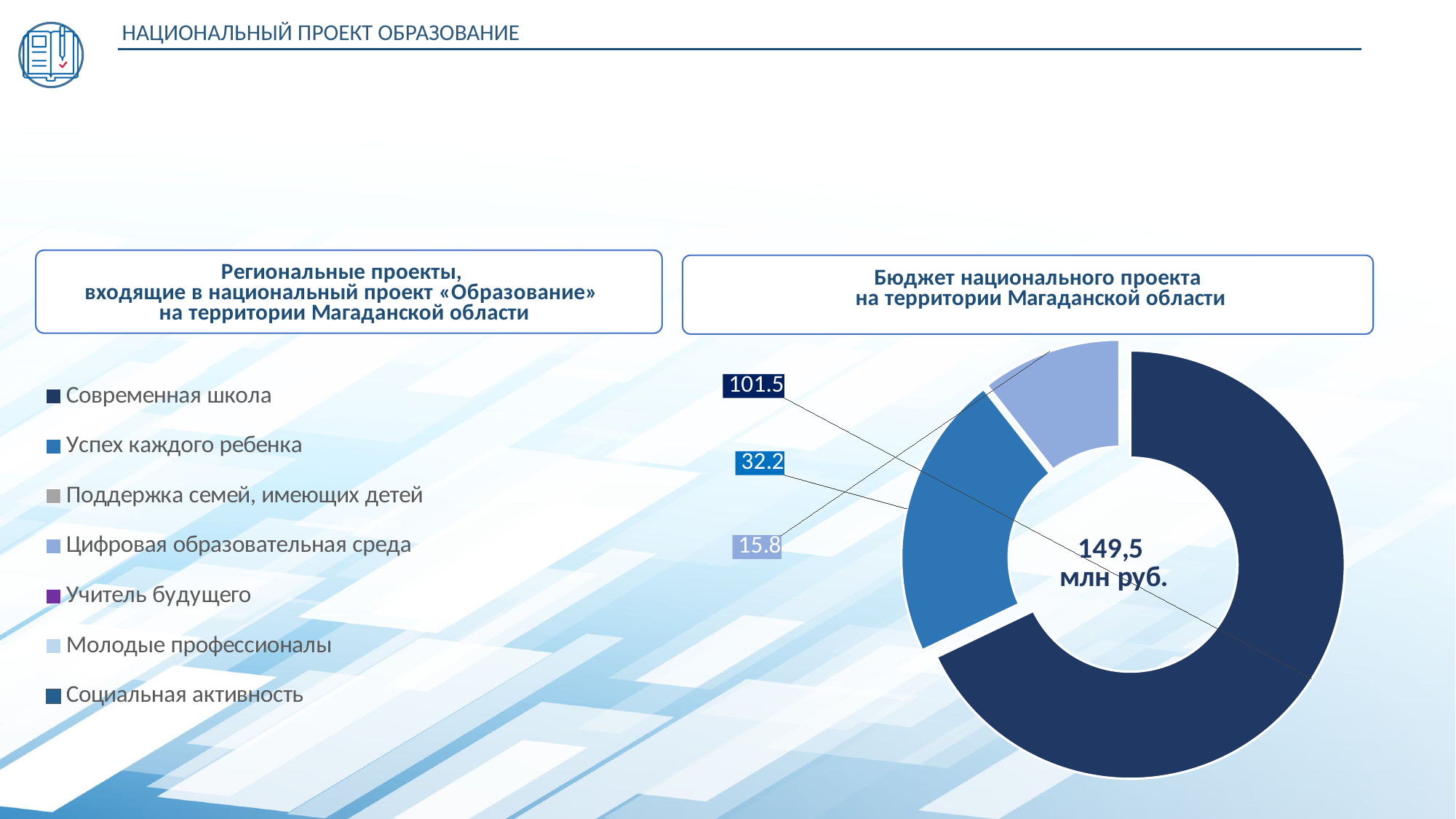
What is the value of the largest slice in the donut chart? 101.5 How many data labels (slices with values) are shown on the donut chart? 3 Which slice of the donut chart has the smallest value? 15.8 (Цифровая образовательная среда) Which is larger in the donut chart: the slice labelled 32.2 or the slice labelled 15.8? 32.2 Which slice of the donut chart has the largest value? 101.5 (Современная школа) What value is labelled on the medium-blue slice of the donut chart (Успех каждого ребенка)? 32.2 What is the difference between the slices labelled 32.2 and 15.8 in the donut chart? 16.4 What total is printed in the centre of the donut chart? 149,5 млн руб. What value is labelled on the light-blue slice of the donut chart (Цифровая образовательная среда)? 15.8 What kind of chart is shown under the title «Бюджет национального проекта на территории Магаданской области»? Donut (pie) chart How many entries does the legend on the left of the slide list? 7 What is the difference between the largest slice (101.5) and the smallest slice (15.8) in the donut chart? 85.7